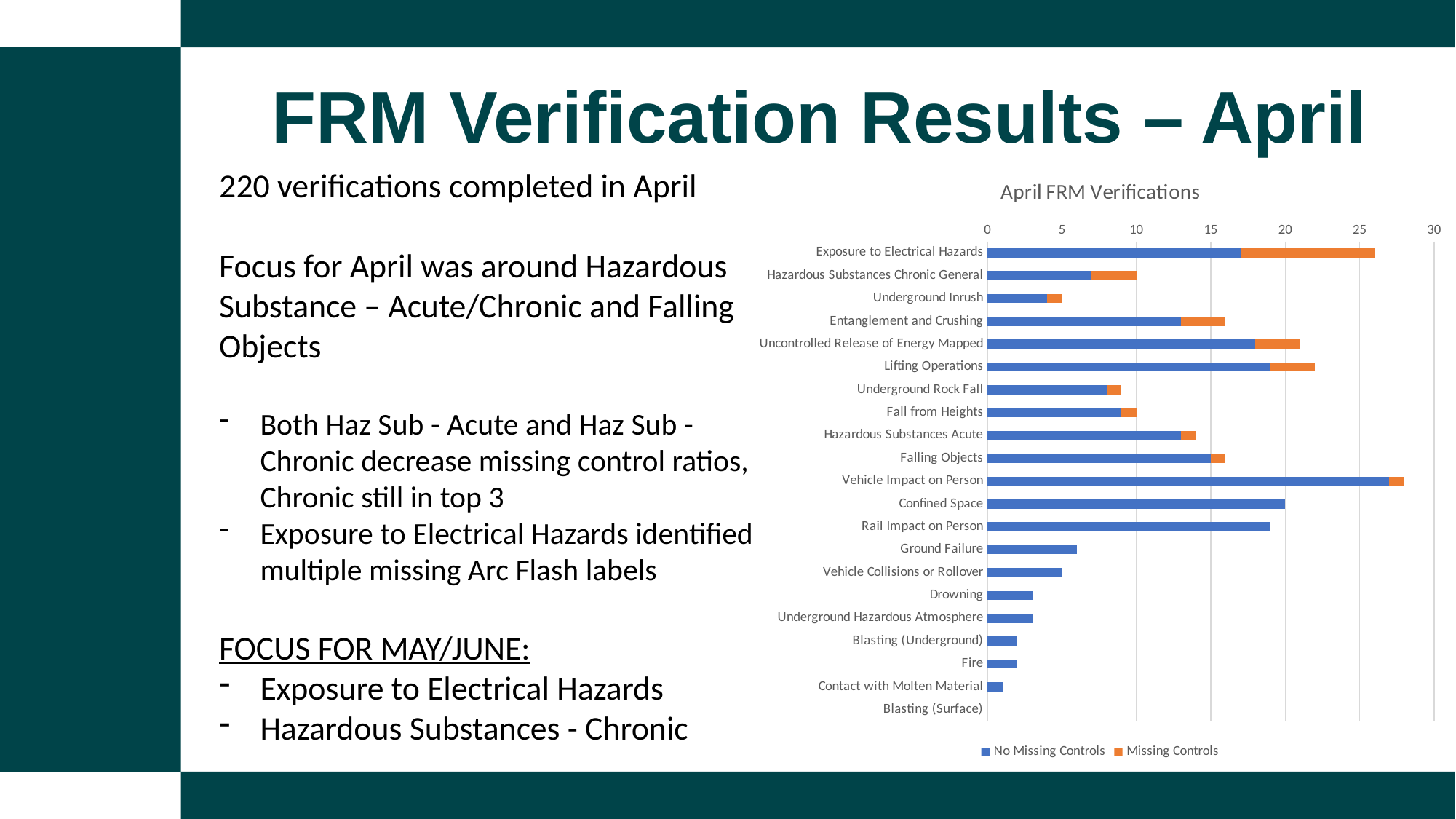
How many series does the chart legend list? 2 Is the total value for Ground Failure greater or less than 10? less How many categories are shown on the chart's vertical axis? 21 Which category has the largest Missing Controls segment? Exposure to Electrical Hazards What is the title of the chart? April FRM Verifications Which has the larger total bar, Lifting Operations or Falling Objects? Lifting Operations Which category has the longest total bar? Vehicle Impact on Person What kind of chart is shown on the slide? Bar chart Is the total value for Exposure to Electrical Hazards greater or less than 20? greater Is the total value for Vehicle Impact on Person greater or less than 25? greater What are the two series named in the legend? No Missing Controls and Missing Controls